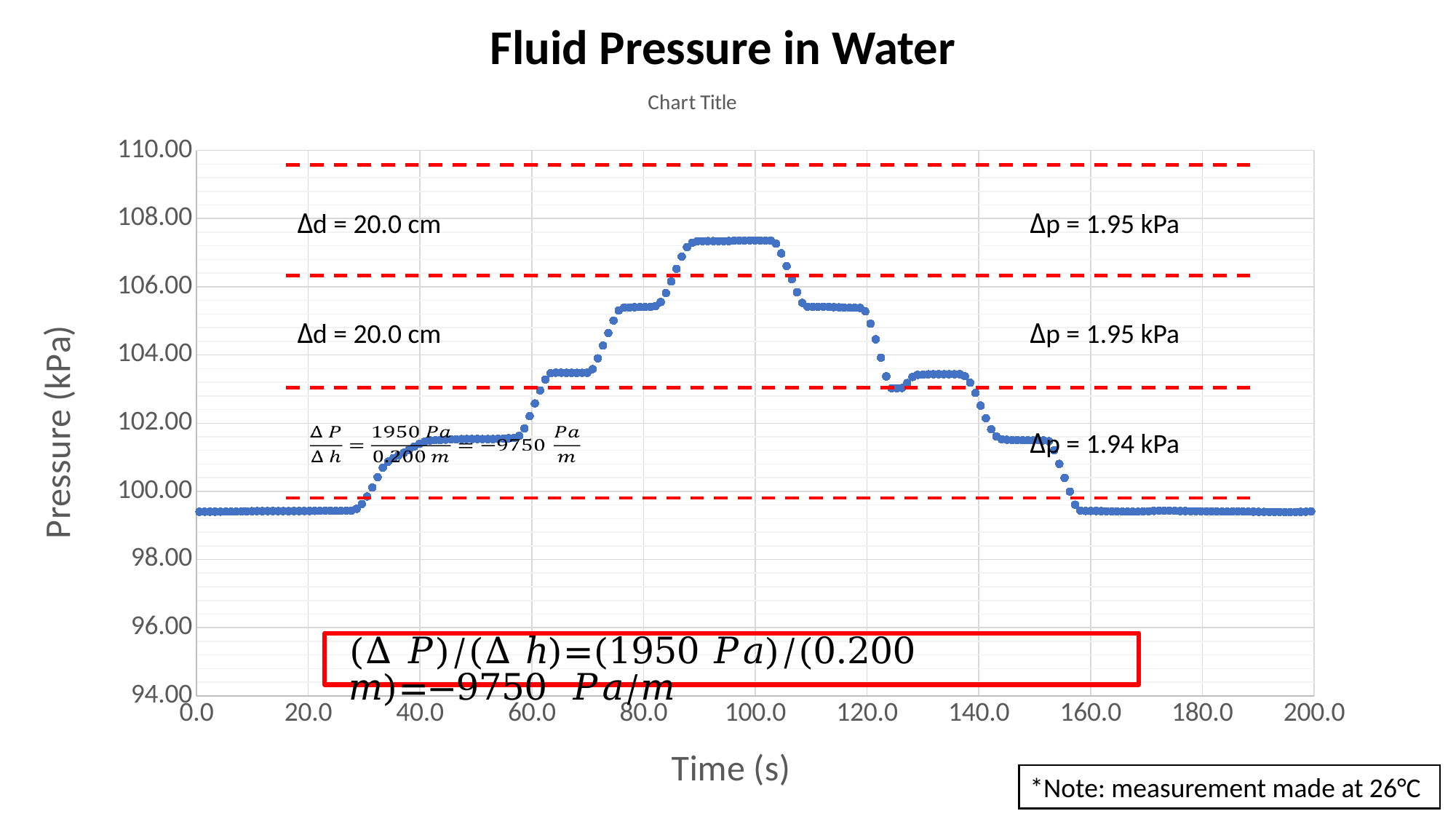
What is the label of the vertical axis? Pressure (kPa) Which is larger, the pressure at time 100.0 s or the pressure at time 150.0 s? the pressure at 100.0 s Is the pressure at time 70.0 s greater or less than 104.00 kPa? less Is the pressure at time 180.0 s greater or less than 100.00 kPa? less Does the pressure rise or fall between time 100.0 s and time 160.0 s? fall What kind of chart is shown on the slide? scatter chart Does the pressure rise or fall between time 20.0 s and time 100.0 s? rise Is the pressure at time 110.0 s greater or less than 104.00 kPa? greater What is the label of the horizontal axis? Time (s)